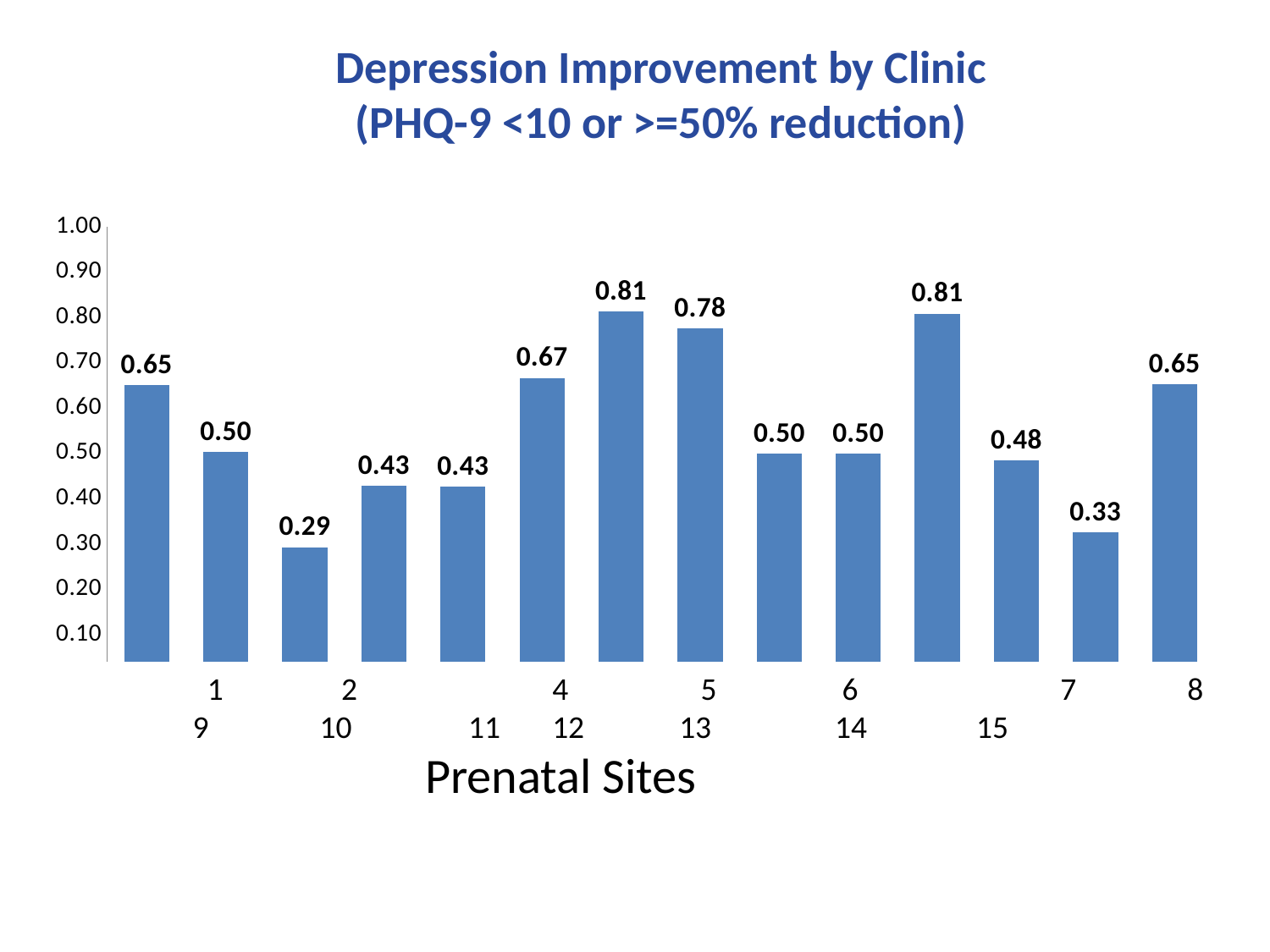
How many bars in the chart have a value of 0.50? 3 What is the difference between the highest value (0.81) and the lowest value (0.29) in the chart? 0.52 What is the label on the x axis of the chart? Prenatal Sites What is the highest value shown in the chart? 0.81 What is the value of the third bar from the left? 0.29 How many bars are plotted in the chart? 14 What is the value of the leftmost bar in the chart? 0.65 What is the title of the chart? Depression Improvement by Clinic (PHQ-9 <10 or >=50% reduction) What is the value of the rightmost bar in the chart? 0.65 Which is larger, the leftmost bar or the second bar from the left? the leftmost bar What type of chart is shown on the slide? bar chart What is the lowest value shown in the chart? 0.29